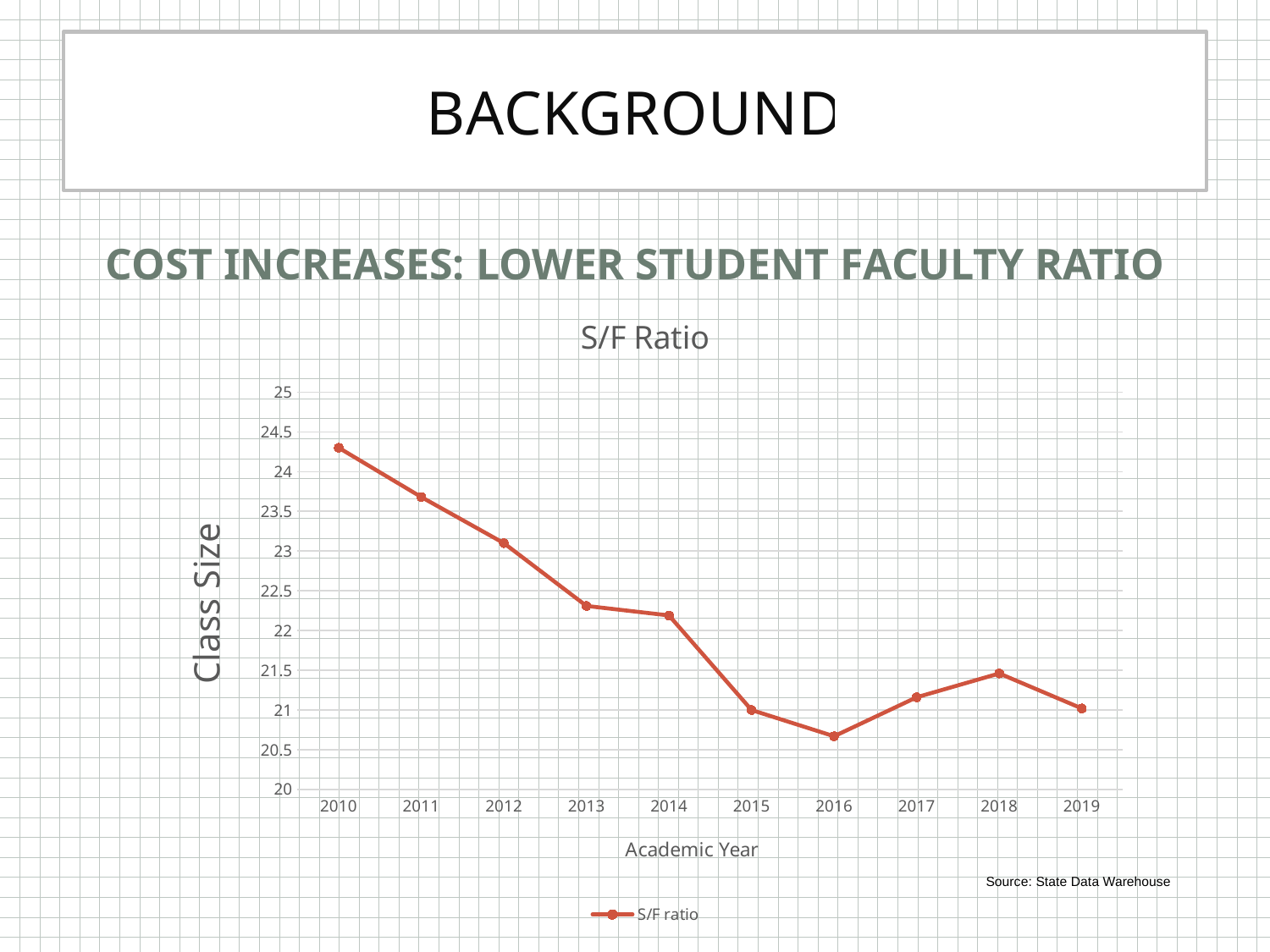
Is the S/F ratio for 2010 greater or less than 24? greater Is the S/F ratio for 2016 greater or less than 21? less Which has a higher S/F ratio, 2010 or 2019? 2010 What is the title of the chart? S/F Ratio Does the S/F ratio generally rise or fall from 2010 to 2016? fall How many academic years are plotted on the x axis? 10 What kind of chart is shown on the slide? line chart Is the S/F ratio for 2013 greater or less than 22? greater How many series does the legend list? 1 Which academic year has the lowest S/F ratio? 2016 Which academic year has the highest S/F ratio? 2010